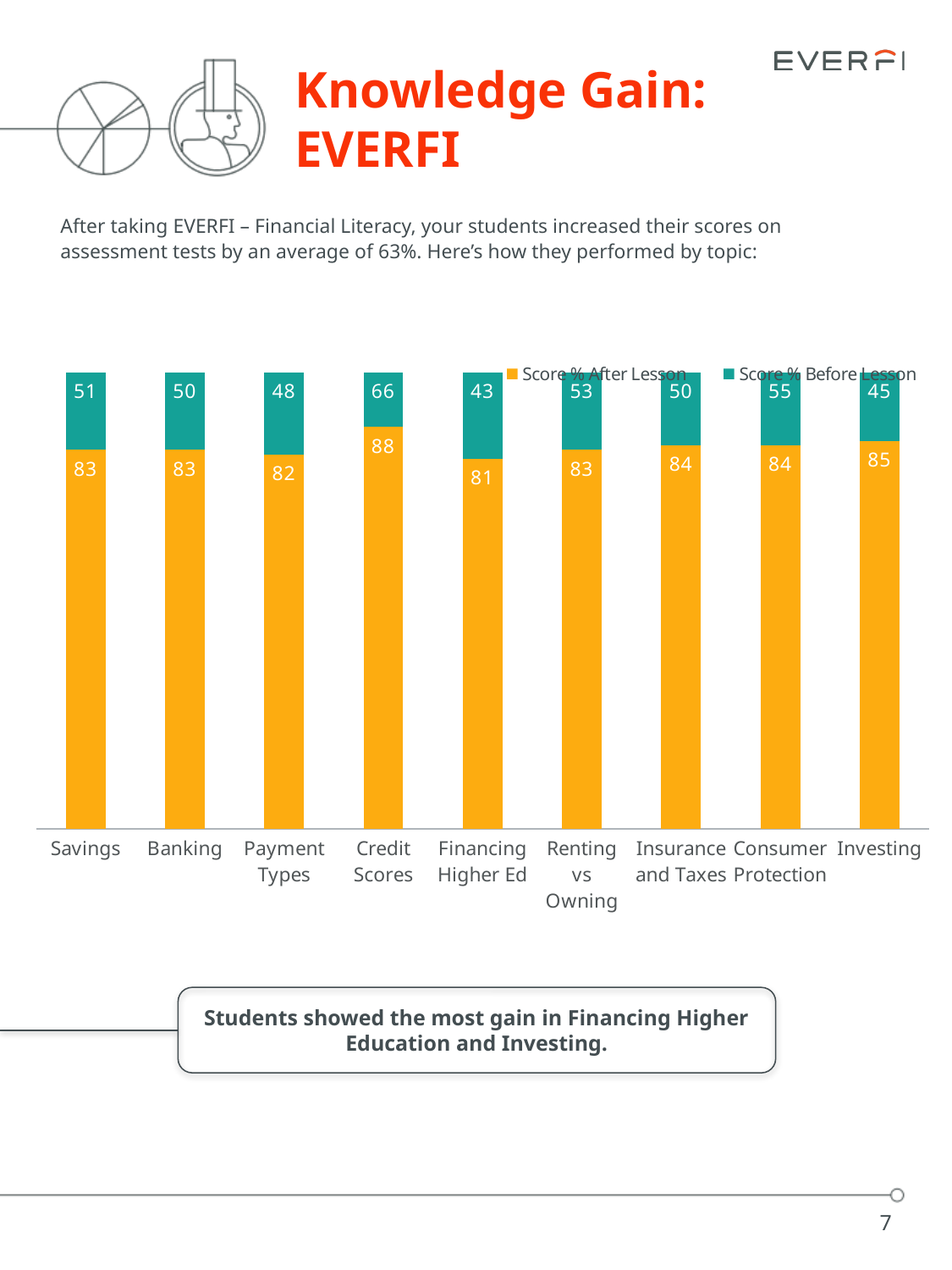
Which topic has the lowest Score % Before Lesson? Financing Higher Ed What is the sum of the two printed values in the Savings bar? 134 How many topics are shown on the x axis of the chart? 9 What is the Score % After Lesson for Credit Scores? 88 How many series does the chart legend list? 2 What is the Score % Before Lesson for Financing Higher Ed? 43 What kind of chart is shown on the slide? Stacked bar chart Which topic has the highest Score % After Lesson? Credit Scores What is the Score % After Lesson for Investing? 85 What is the difference between the Score % After Lesson and the Score % Before Lesson for Financing Higher Ed? 38 What is the Score % Before Lesson for Consumer Protection? 55 Which is larger: the Score % Before Lesson for Credit Scores or for Renting vs Owning? Credit Scores